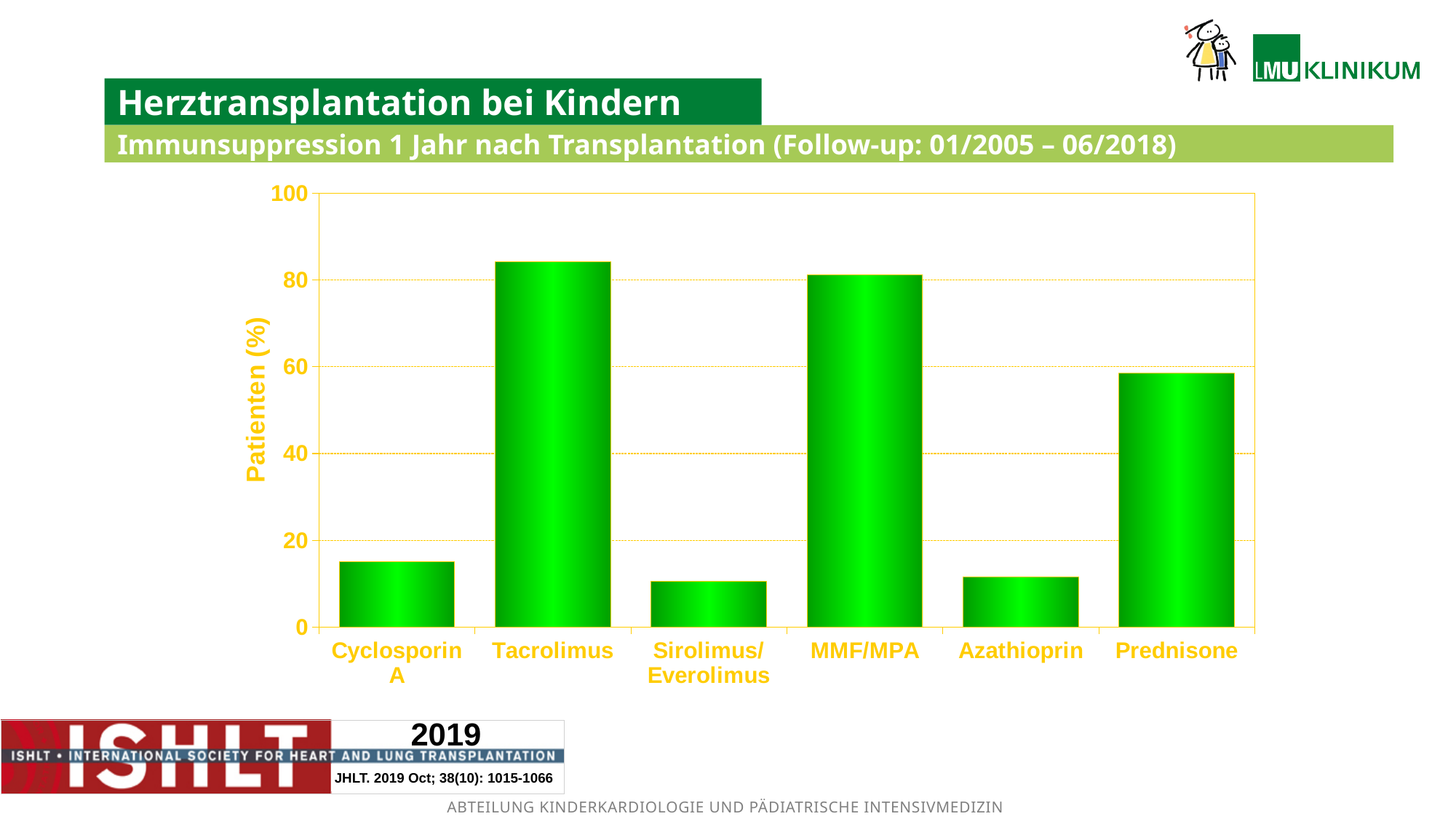
Is the value for MMF/MPA greater or less than 60? greater Which immunosuppressant has the highest value in the chart? Tacrolimus What is the label of the y axis of the chart? Patienten (%) Which has a larger value, MMF/MPA or Azathioprin? MMF/MPA Which has a larger value, Tacrolimus or Prednisone? Tacrolimus Which has a larger value, Cyclosporin A or Prednisone? Prednisone Is the value for Tacrolimus greater or less than 80? greater Is the value for Cyclosporin A greater or less than 20? less How many categories (immunosuppressants) are shown on the x axis of the chart? 6 What kind of chart is shown on the slide? bar chart